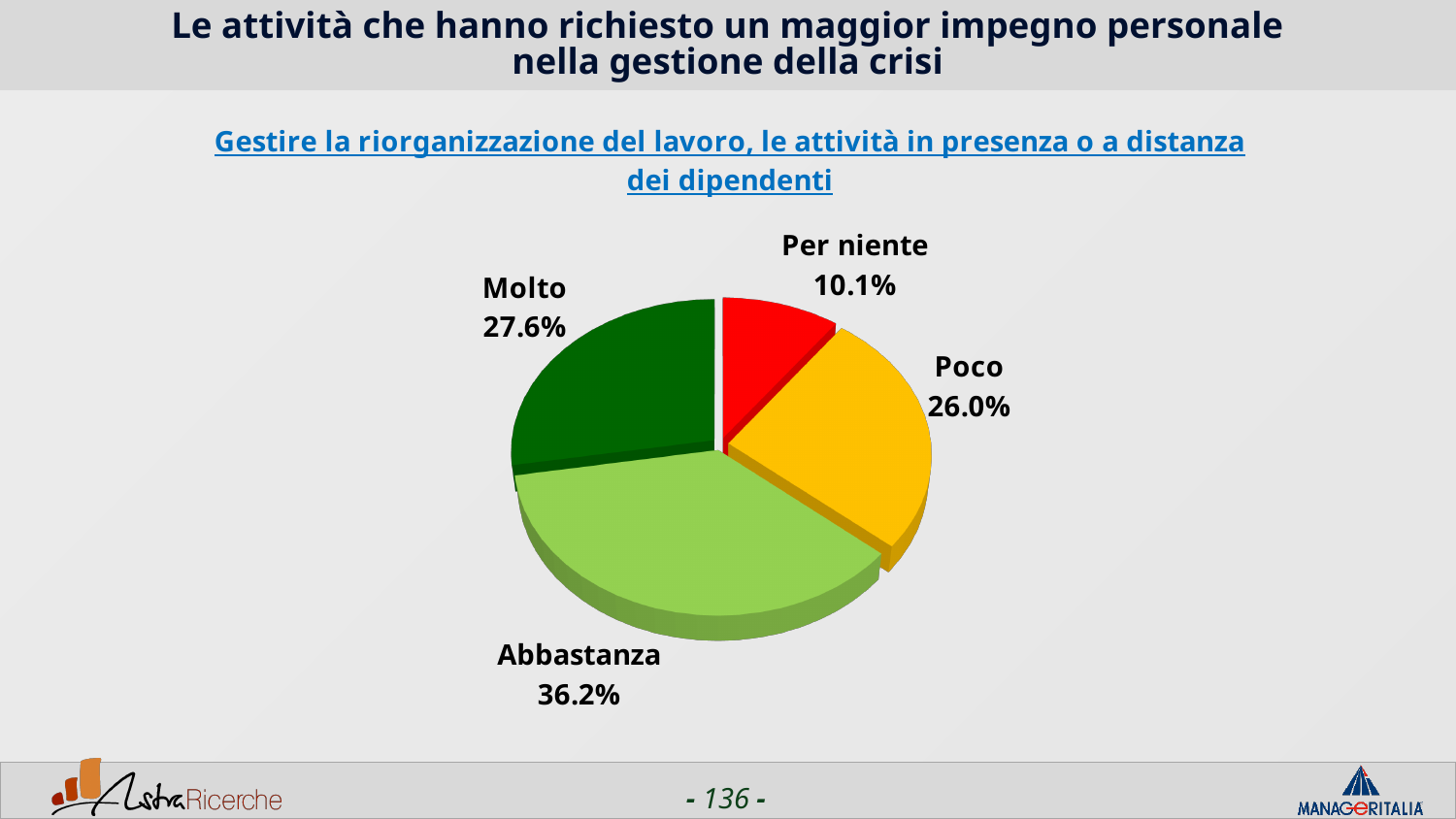
How many slices does the pie chart have? 4 What is the difference between the values for "Abbastanza" and "Molto"? 8.6% What kind of chart is shown on the slide? pie chart What is the value for "Poco"? 26.0% What colour is the slice for "Per niente"? red Which category has the largest share of the pie? Abbastanza What is the value for "Abbastanza"? 36.2% Which category has the smallest share of the pie? Per niente What is the value for "Per niente"? 10.1% What is the value for "Molto"? 27.6% Which is larger, the value for "Molto" or the value for "Poco"? Molto What is the combined share of "Molto" and "Abbastanza"? 63.8%